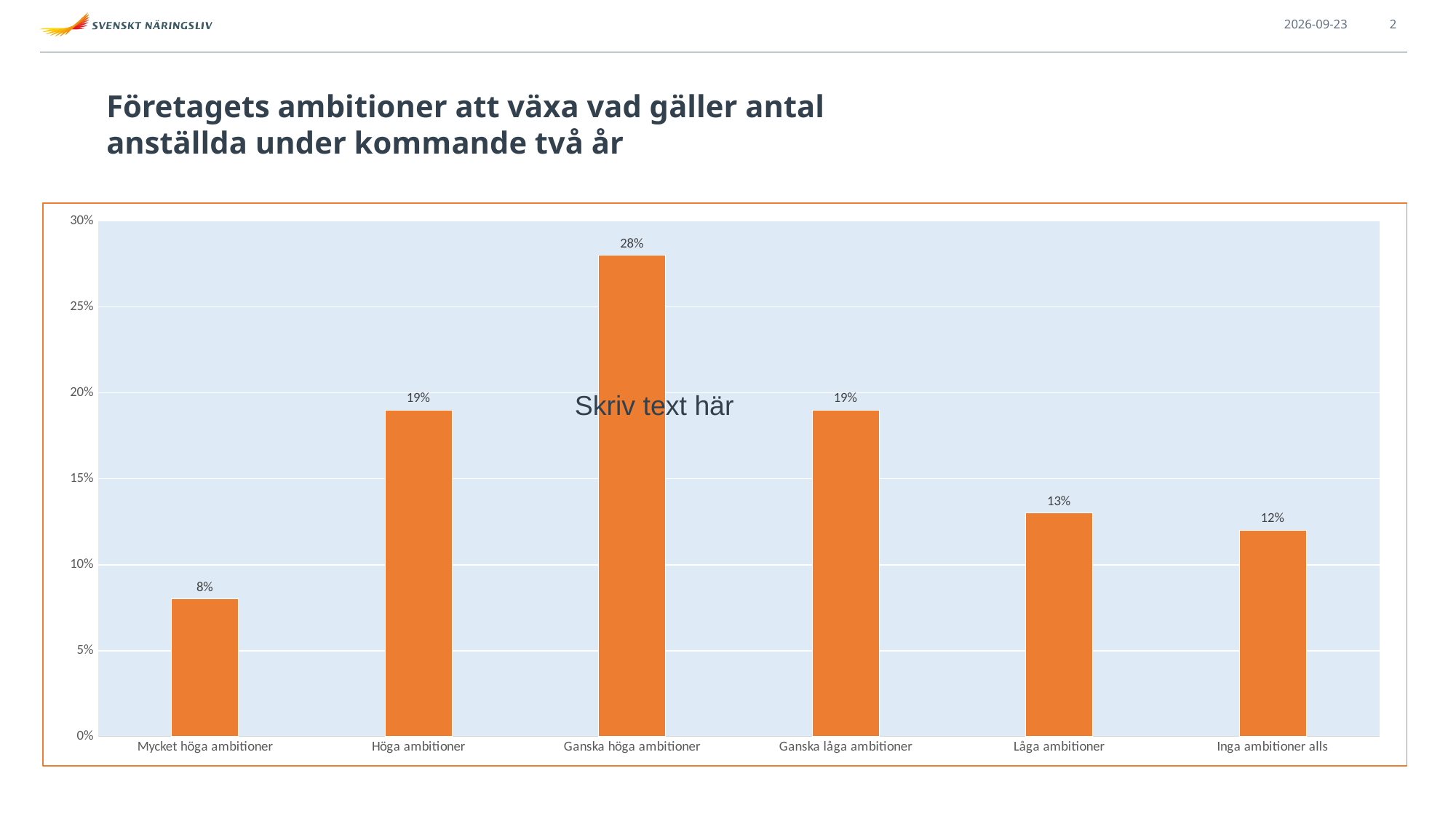
Which category has the lowest value? Mycket höga ambitioner Which category has the highest value? Ganska höga ambitioner Is the value for Ganska låga ambitioner greater or less than 15%? greater What is the value for Låga ambitioner? 13% What colour are the bars in the chart? Orange What kind of chart is shown on the slide? Bar chart What is the value for Mycket höga ambitioner? 8% Which is larger, the value for Låga ambitioner or the value for Mycket höga ambitioner? Låga ambitioner What is the difference between the values for Ganska höga ambitioner and Höga ambitioner? 9% How many categories are shown on the x axis? 6 What is the value for Ganska höga ambitioner? 28% What is the value for Inga ambitioner alls? 12%